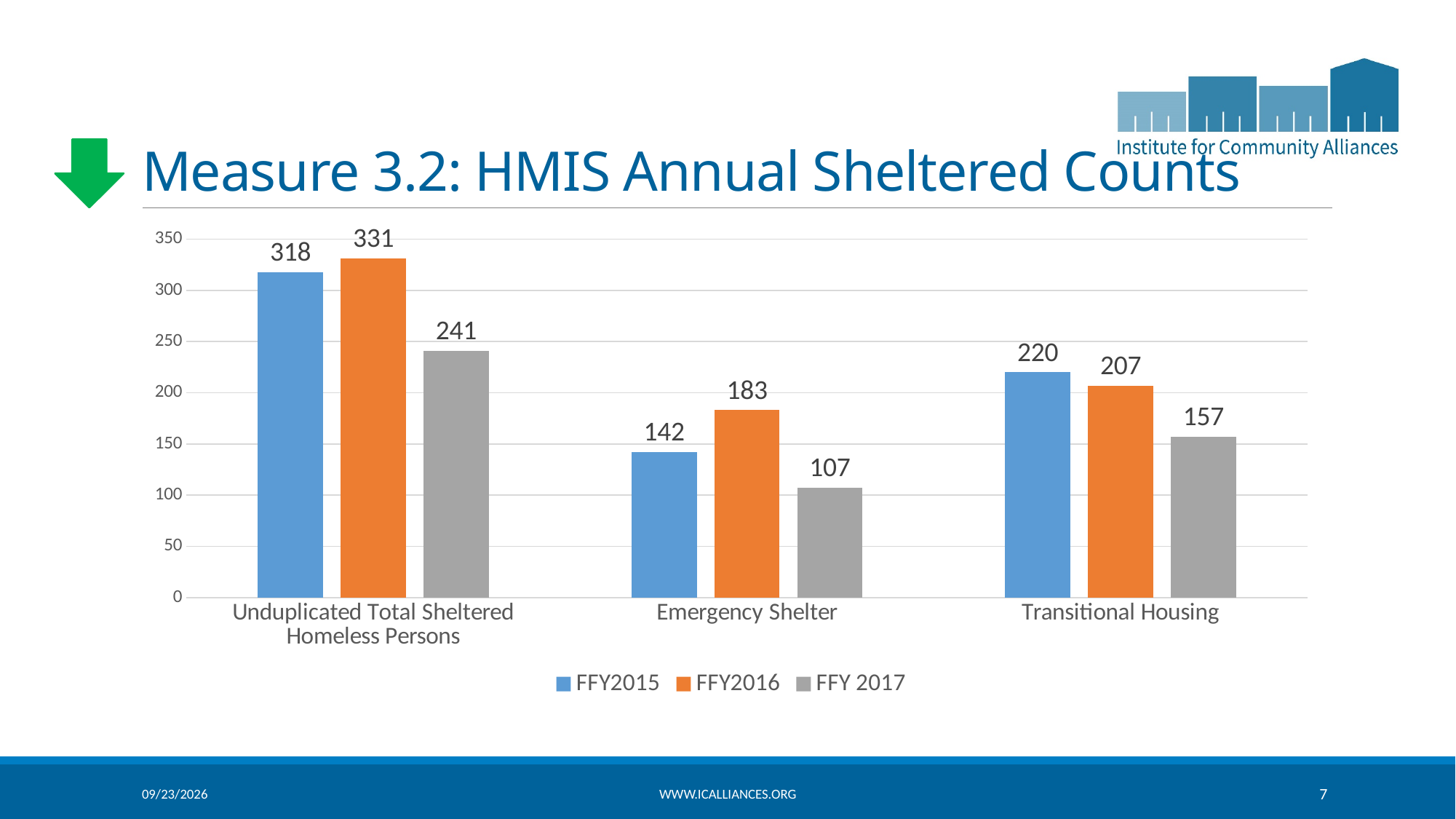
Which year has the highest value for Unduplicated Total Sheltered Homeless Persons? FFY2016 How many categories are shown on the x axis? 3 What colour are the FFY2016 bars? Orange What is the FFY2015 value for Unduplicated Total Sheltered Homeless Persons? 318 Which year has the lowest value for Emergency Shelter? FFY 2017 What is the FFY 2017 value for Transitional Housing? 157 How many series does the legend list? 3 What is the difference between the FFY2015 and FFY 2017 values for Transitional Housing? 63 What kind of chart is shown on the slide? Bar chart What is the difference between the FFY2016 and FFY2015 values for Emergency Shelter? 41 Which is larger for Transitional Housing: the FFY2015 value or the FFY2016 value? FFY2015 What is the FFY2016 value for Emergency Shelter? 183